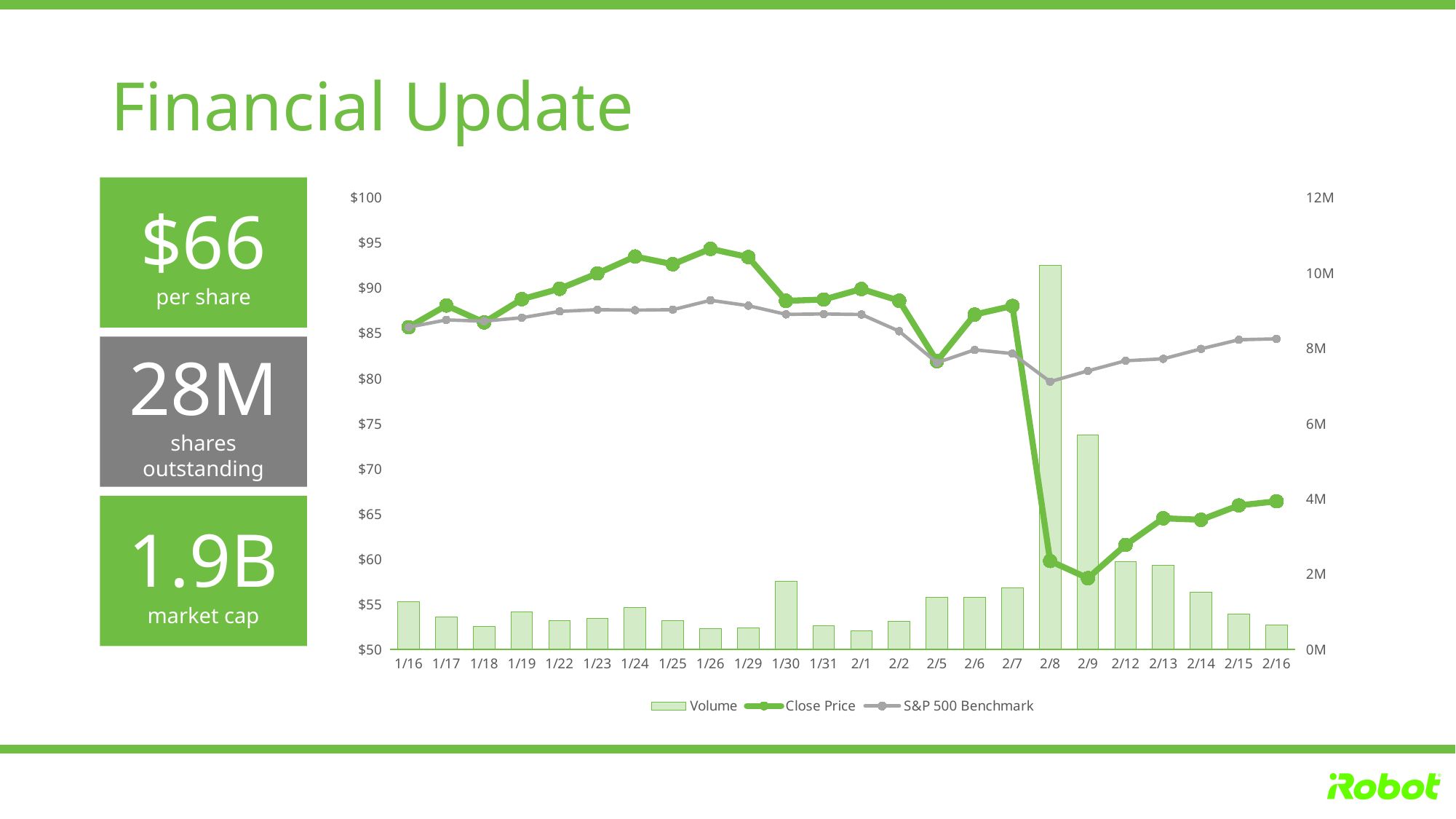
How many series does the chart's legend list? 3 Is the Volume on 2/8 greater or less than 10M? greater Does the Close Price rise or fall from 2/9 to 2/16? rise Which is larger, the Close Price on 1/16 or the Close Price on 2/16? 1/16 What are the three series named in the chart's legend? Volume, Close Price, S&P 500 Benchmark On which date is the Close Price lowest? 2/9 Is the Close Price on 1/16 greater or less than $80? greater What kind of chart is shown on the slide? A combined bar and line chart Is the Close Price on 2/16 greater or less than $70? less On which date is the Volume bar highest? 2/8 How many dates are shown along the x axis of the chart? 24